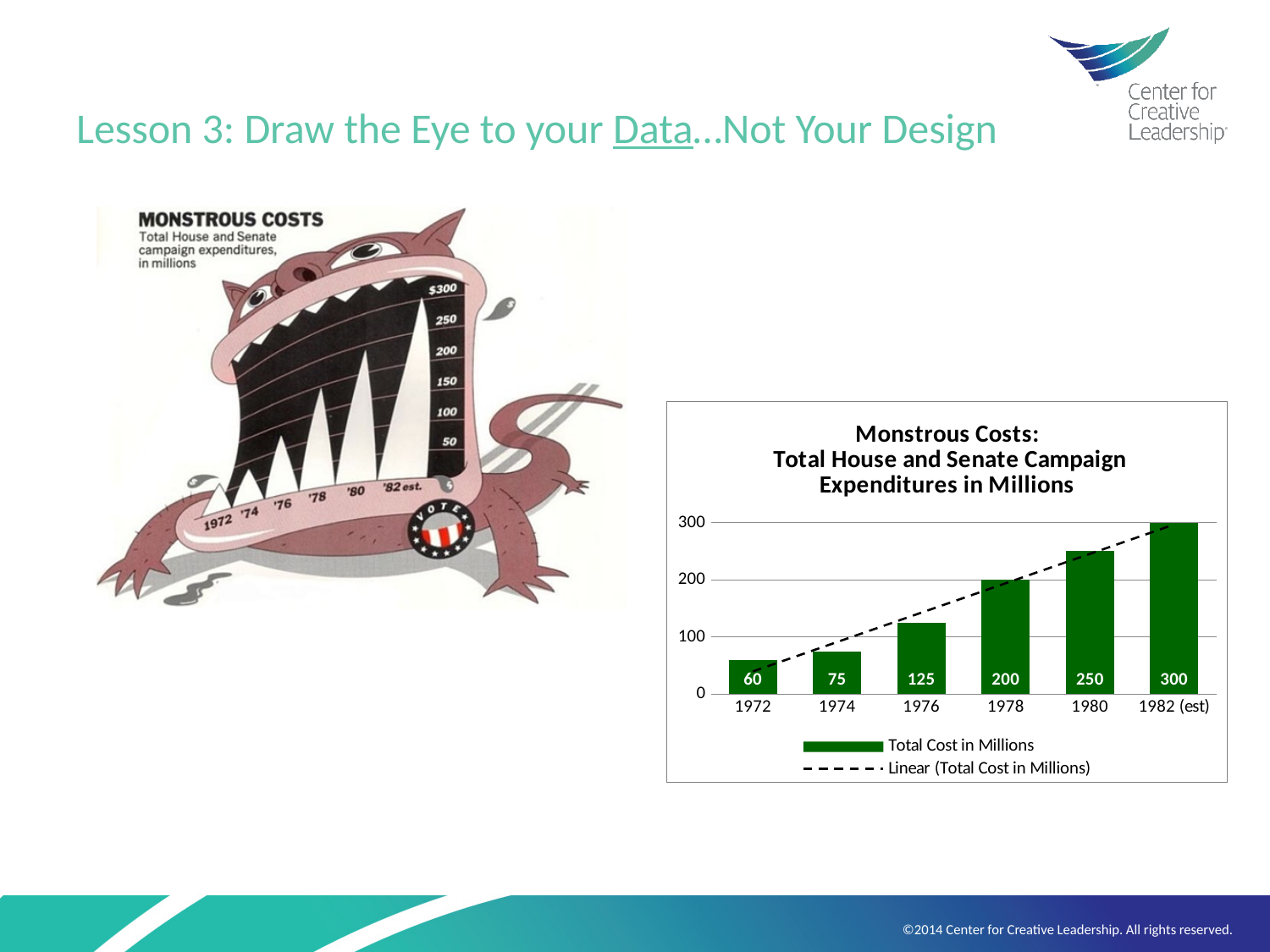
In the bar chart on the right, which year has the highest Total Cost in Millions? 1982 (est) Do the values in the bar chart on the right rise or fall from 1972 to 1982 (est)? rise In the bar chart on the right, what is the difference between the values for 1980 and 1978? 50 In the bar chart on the right, what is the difference between the values for 1976 and 1974? 50 In the bar chart on the right, what is the value for 1982 (est)? 300 In the bar chart on the right, what is the Total Cost in Millions for 1976? 125 In the bar chart on the right, which year has the lowest Total Cost in Millions? 1972 In the bar chart on the right, is the value for 1980 greater or less than 200? greater How many entries does the legend of the bar chart on the right list? 2 In the bar chart on the right, which is larger, the value for 1974 or the value for 1978? 1978 In the bar chart on the right, what is the Total Cost in Millions for 1972? 60 How many years are shown on the x axis of the bar chart on the right? 6